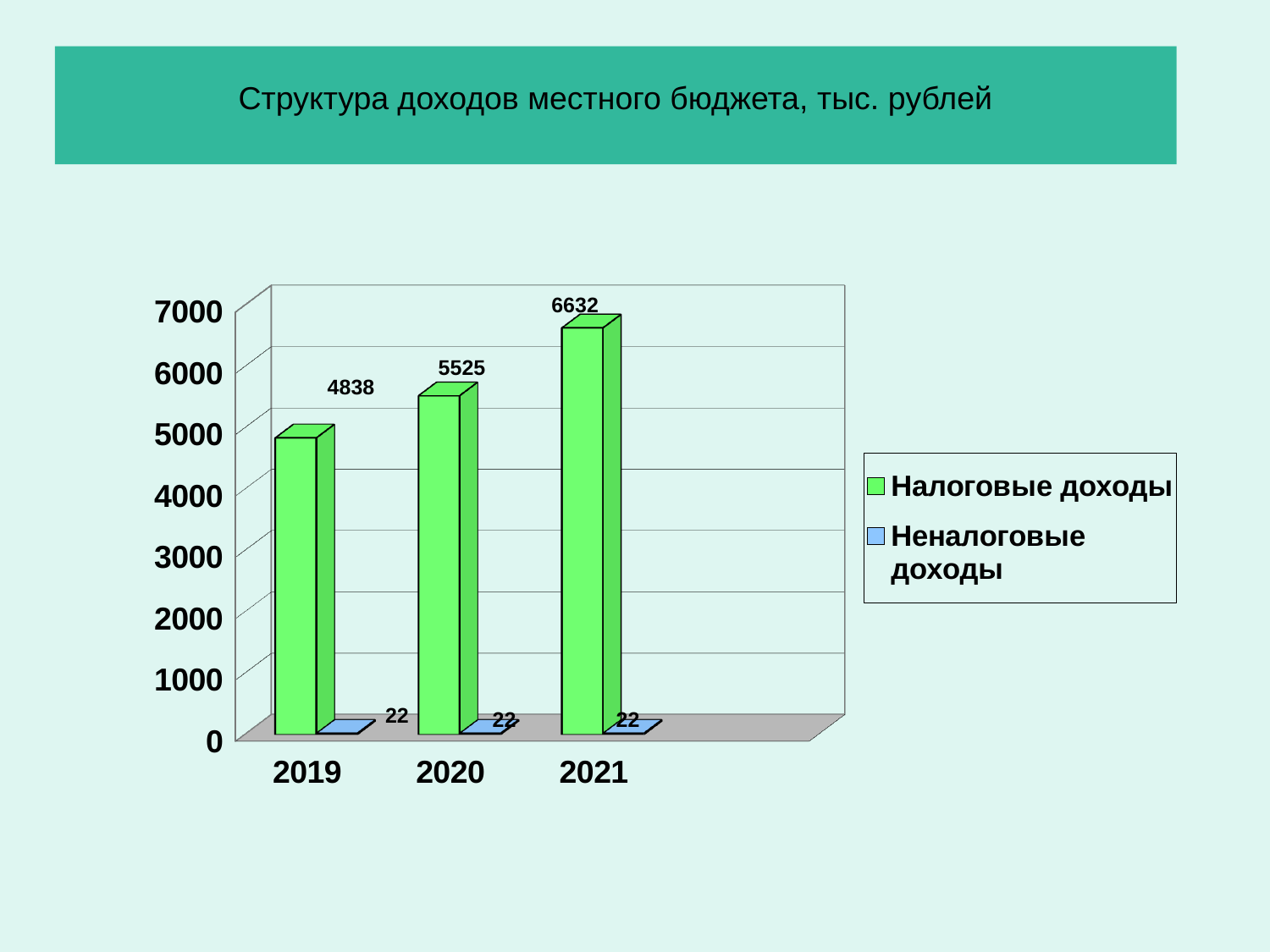
What is the difference between Налоговые доходы in 2020 and in 2019? 687 How many series does the legend list? 2 Do the values for Налоговые доходы rise or fall from 2019 to 2021? Rise What is the difference between Налоговые доходы in 2021 and in 2019? 1794 What is the value of Налоговые доходы for 2021? 6632 Which year has the highest value for Налоговые доходы? 2021 How many years are shown on the x axis? 3 What kind of chart is shown on the slide? Bar chart What is the value of Налоговые доходы for 2019? 4838 What is the value of Неналоговые доходы for 2020? 22 Which is larger: Налоговые доходы in 2020 or in 2021? 2021 Which year has the lowest value for Налоговые доходы? 2019